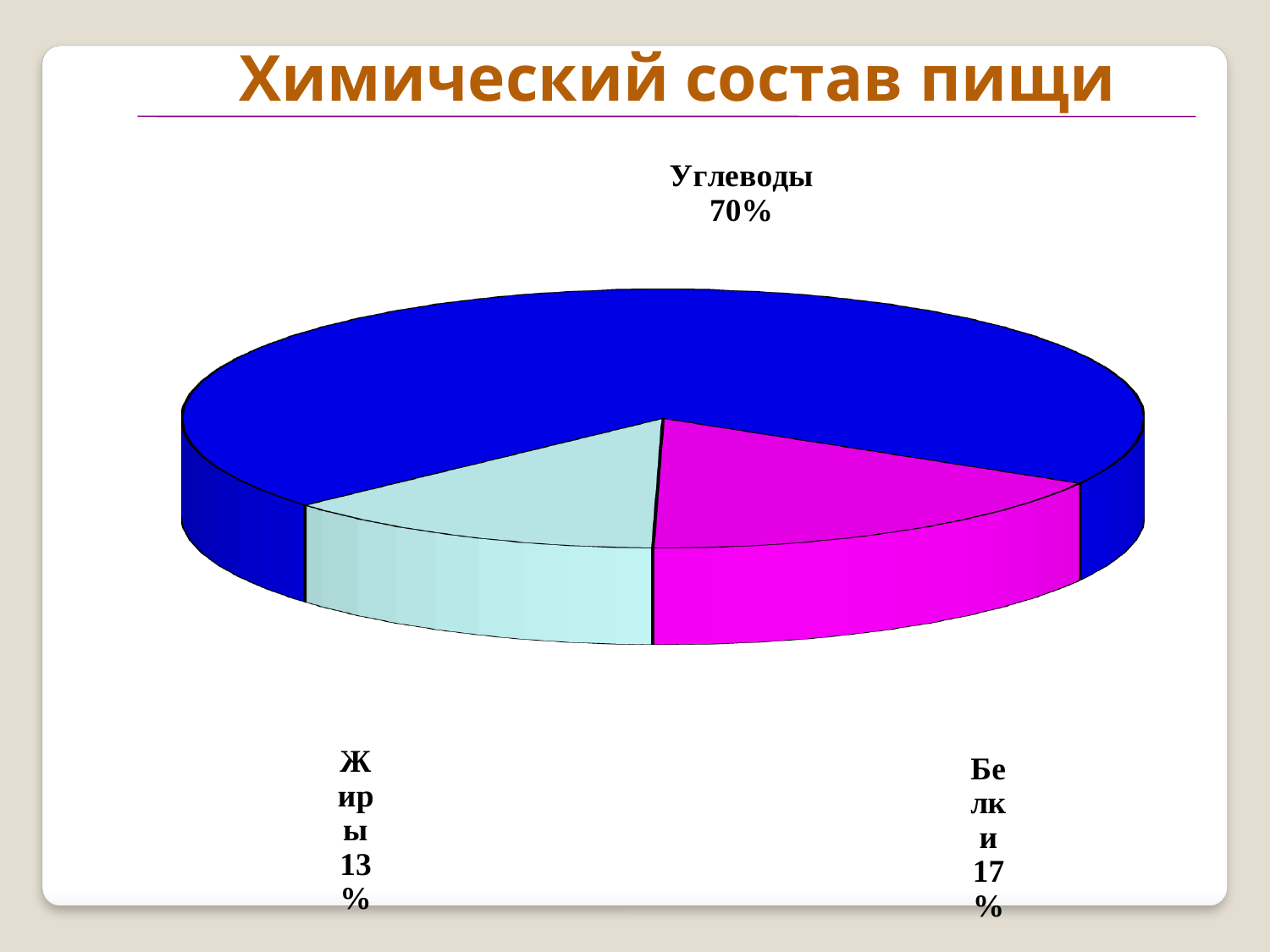
What is the difference in percentage points between Углеводы and Белки? 53 What is the difference in percentage points between Белки and Жиры? 4 Which is larger, the share for Белки or the share for Жиры? Белки Which slice of the pie is the largest? Углеводы What percentage of the pie is labelled Белки? 17% What percentage of the pie is labelled Углеводы? 70% Which slice of the pie is the smallest? Жиры What kind of chart is shown on the slide? pie chart What is the title of the slide containing the pie chart? Химический состав пищи How many slices does the pie chart have? 3 What colour is the Углеводы slice of the pie? blue What percentage of the pie is labelled Жиры? 13%